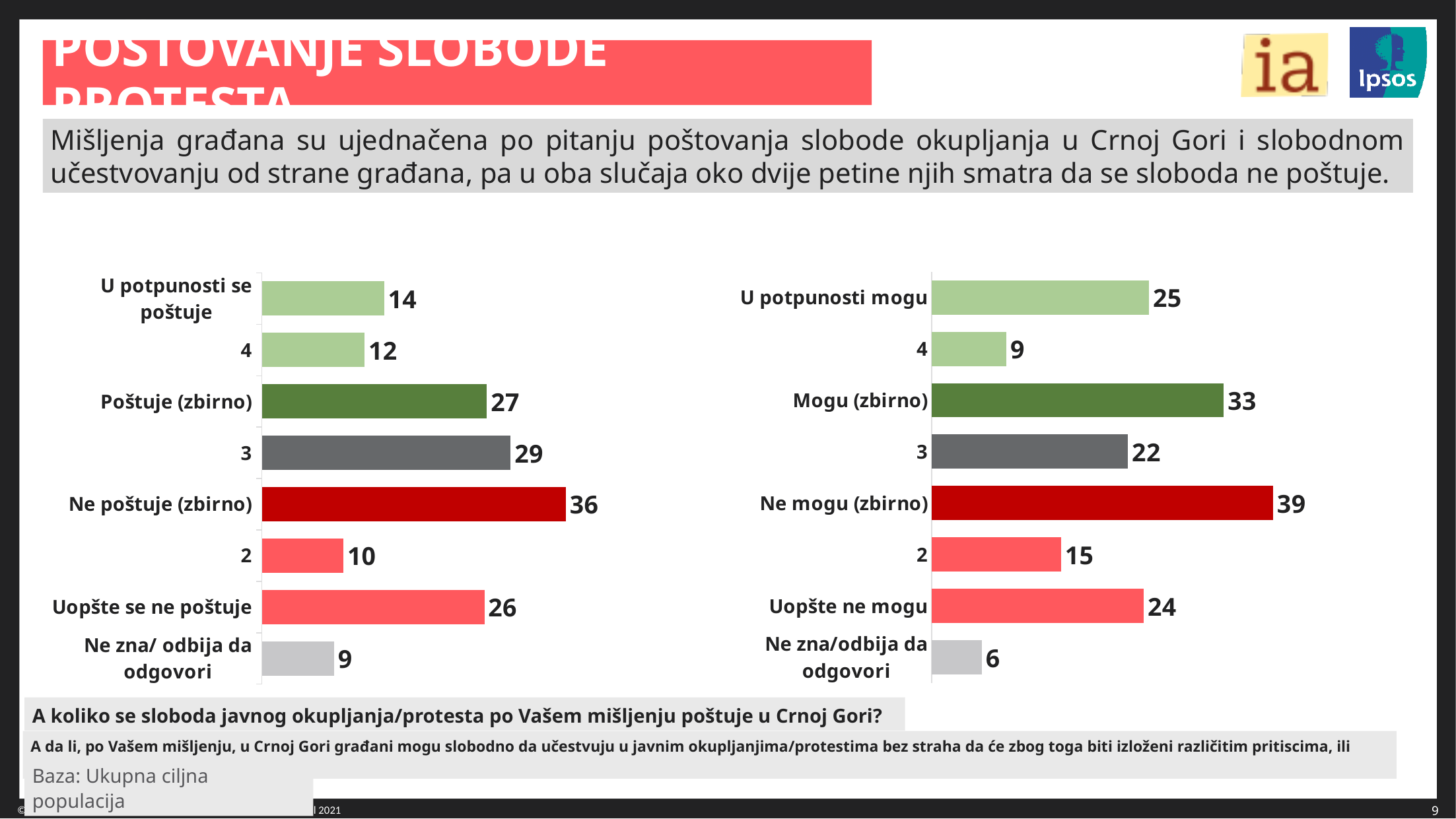
In the left chart, which category has the highest value? Ne poštuje (zbirno) In the left chart, what is the difference between "Uopšte se ne poštuje" and "2"? 16 In the right chart, what is the value for "Mogu (zbirno)"? 33 How many categories does the right chart show? 8 In the right chart, which category has the lowest value? Ne zna/odbija da odgovori In the left chart, which is larger: the value for "3" or the value for "Poštuje (zbirno)"? 3 In the right chart, what is the difference between "Ne mogu (zbirno)" and "Mogu (zbirno)"? 6 In the right chart, which is larger: the value for "U potpunosti mogu" or the value for "Uopšte ne mogu"? U potpunosti mogu What type of chart is the left chart? Bar chart In the left chart, what is the value for "U potpunosti se poštuje"? 14 In the right chart, what is the value for "Ne zna/odbija da odgovori"? 6 In the left chart, what is the value for "Ne poštuje (zbirno)"? 36